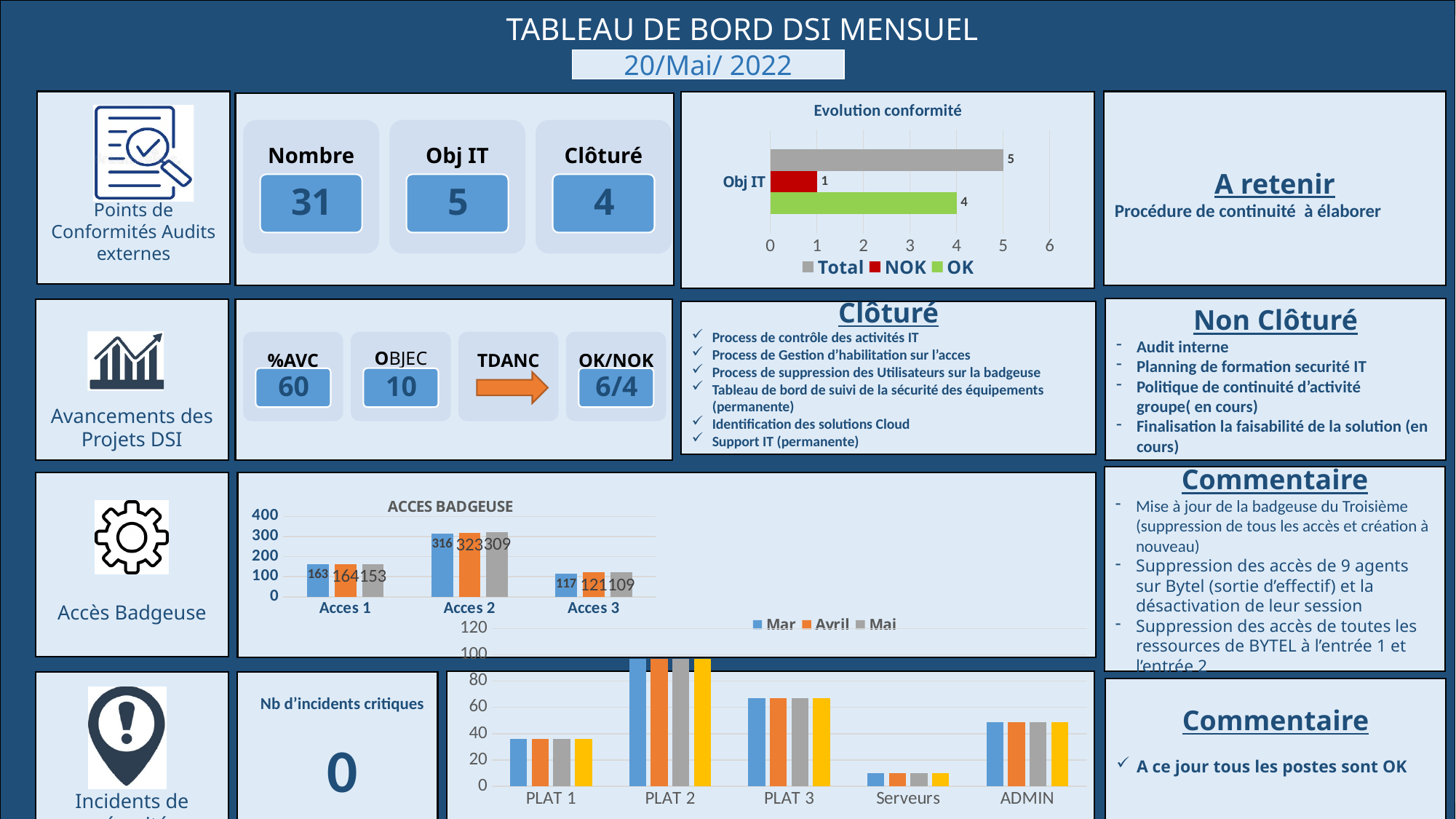
In the 'Evolution conformité' chart, what is the value of the Total series for Obj IT? 5 In the 'Evolution conformité' chart, what is the value of the OK series? 4 In the 'ACCES BADGEUSE' chart, what is the value for Acces 2 in Mar? 316 In the 'ACCES BADGEUSE' chart, what is the value for Acces 3 in Avril? 121 In the 'Evolution conformité' chart, what is the value of the NOK series? 1 In the bottom chart with PLAT 1, PLAT 2, PLAT 3, Serveurs and ADMIN, are the values for PLAT 2 greater or less than 80? greater In the 'Evolution conformité' chart, what is the difference between the Total and OK values? 1 In the bottom chart with PLAT 1, PLAT 2, PLAT 3, Serveurs and ADMIN, which category has the lowest values? Serveurs In the 'ACCES BADGEUSE' chart, which category has the highest values? Acces 2 In the 'Evolution conformité' chart, how many series does the legend list? 3 In the 'ACCES BADGEUSE' chart, how many categories are shown on the x axis? 3 In the 'ACCES BADGEUSE' chart, what is the difference between the Avril and Mai values for Acces 2? 14